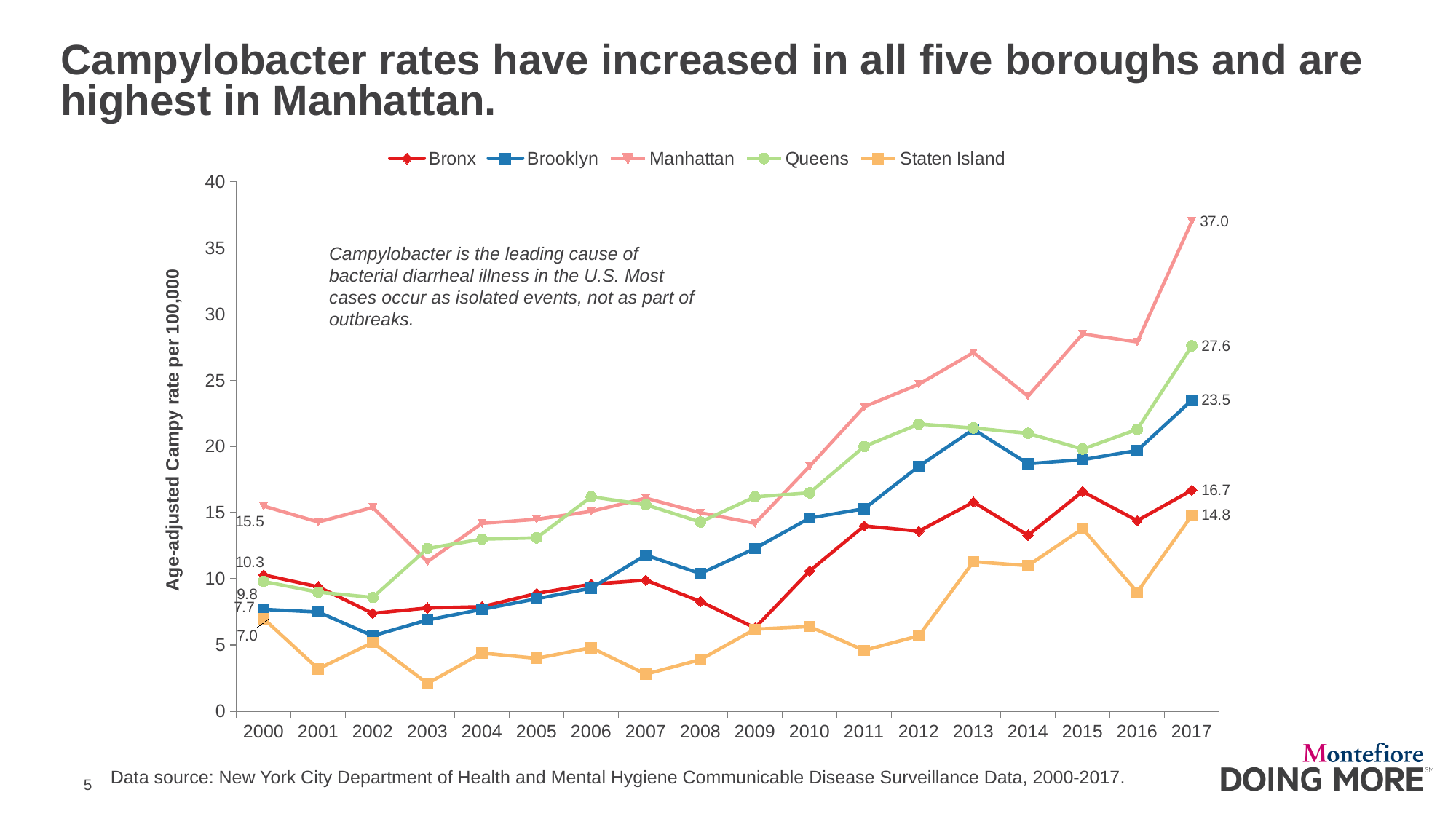
What is the Queens value in 2017? 27.6 By how much did the Manhattan rate increase from 2000 to 2017? 21.5 What is the difference between the Queens and Bronx values in 2017? 10.9 What kind of chart is shown on the slide? line chart Which borough has the highest rate in 2017? Manhattan What is the Manhattan value in 2017? 37.0 How many years are shown on the x axis? 18 Is the Staten Island value for 2003 greater or less than 5? less What is the Staten Island value in 2017? 14.8 How many series does the legend list? 5 What is the Manhattan value in 2000? 15.5 Which borough has the lowest rate in 2017? Staten Island